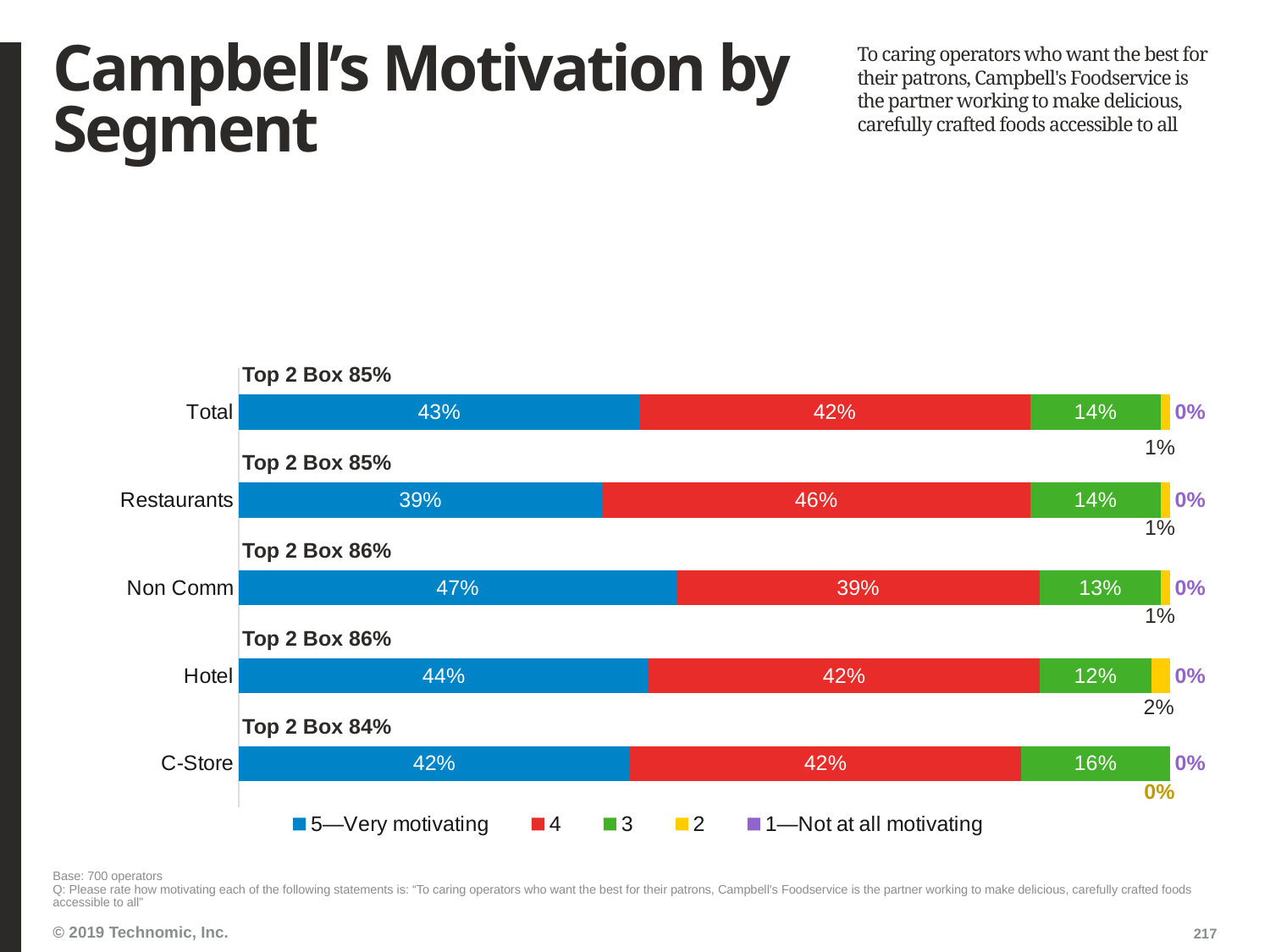
Which segment has the lowest share of 5—Very motivating ratings? Restaurants What is the value for the '2' rating in the Hotel bar? 2% How many percentage points higher is the 5—Very motivating share for Non Comm than for Restaurants? 8 percentage points How many segments are shown on the chart? 5 What is the Top 2 Box value shown for C-Store? 84% What percentage of C-Store operators gave a rating of 3? 16% What percentage of Non Comm operators rated the statement 5—Very motivating? 47% Which segment has the highest share of 5—Very motivating ratings? Non Comm Which has a larger share of '4' ratings, Restaurants or Total? Restaurants Which segment has the highest share of '3' ratings? C-Store How many series does the legend list? 5 What is the value for the '4' rating in the Restaurants bar? 46%